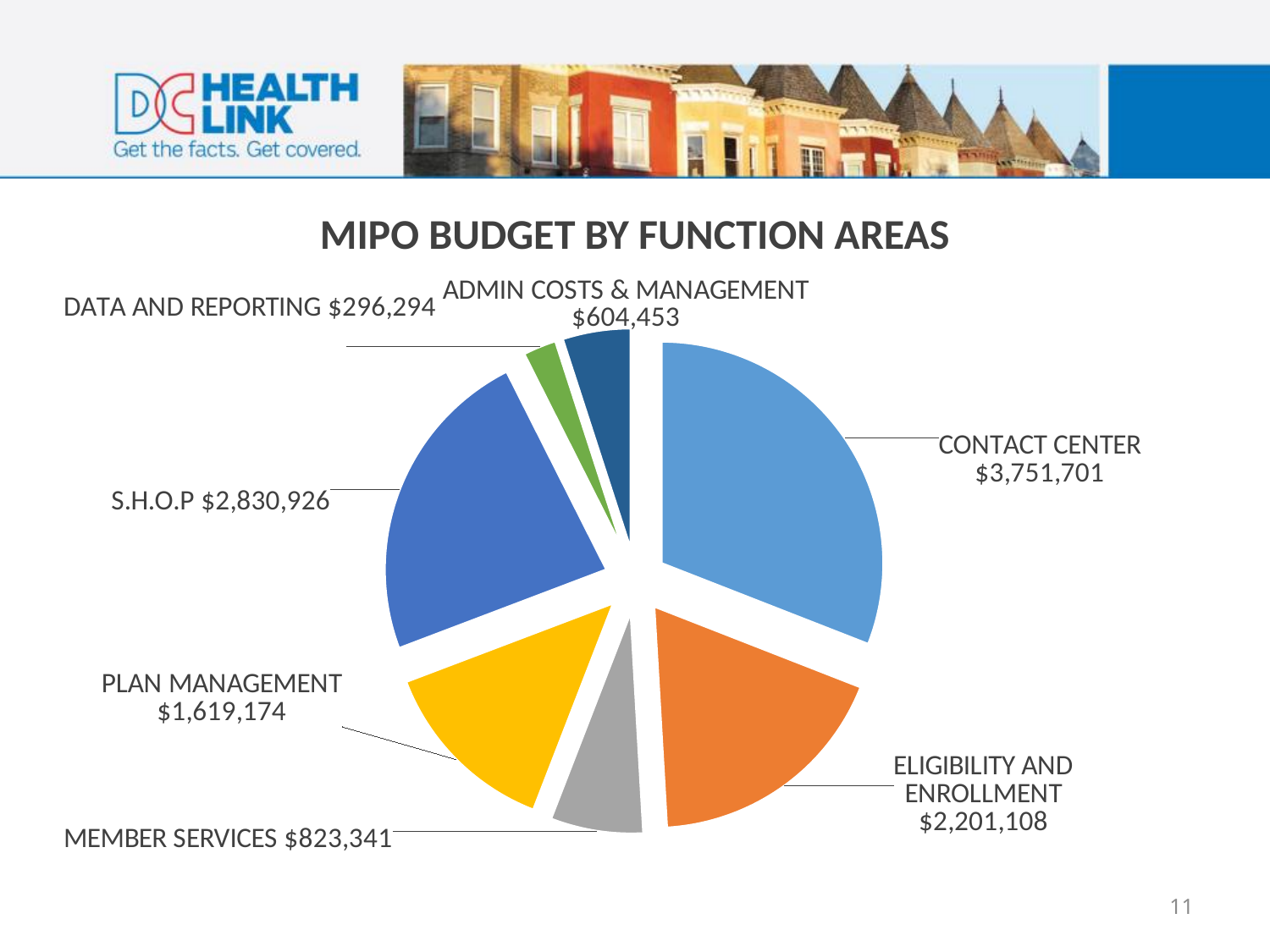
Which function area has the smallest budget? Data and Reporting What is the total budget across all function areas shown in the pie chart? $12,126,997 What type of chart is shown on the slide? Pie chart What is the budget for Plan Management? $1,619,174 What is the budget for Data and Reporting? $296,294 What is the difference between the Contact Center budget and the S.H.O.P budget? $920,775 What is the budget for Contact Center? $3,751,701 Which has a larger budget, S.H.O.P or Eligibility and Enrollment? S.H.O.P How many function areas (slices) does the pie chart show? 7 Which function area has the largest budget? Contact Center What is the title of the chart? MIPO BUDGET BY FUNCTION AREAS What is the difference between the Admin Costs & Management budget and the Data and Reporting budget? $308,159